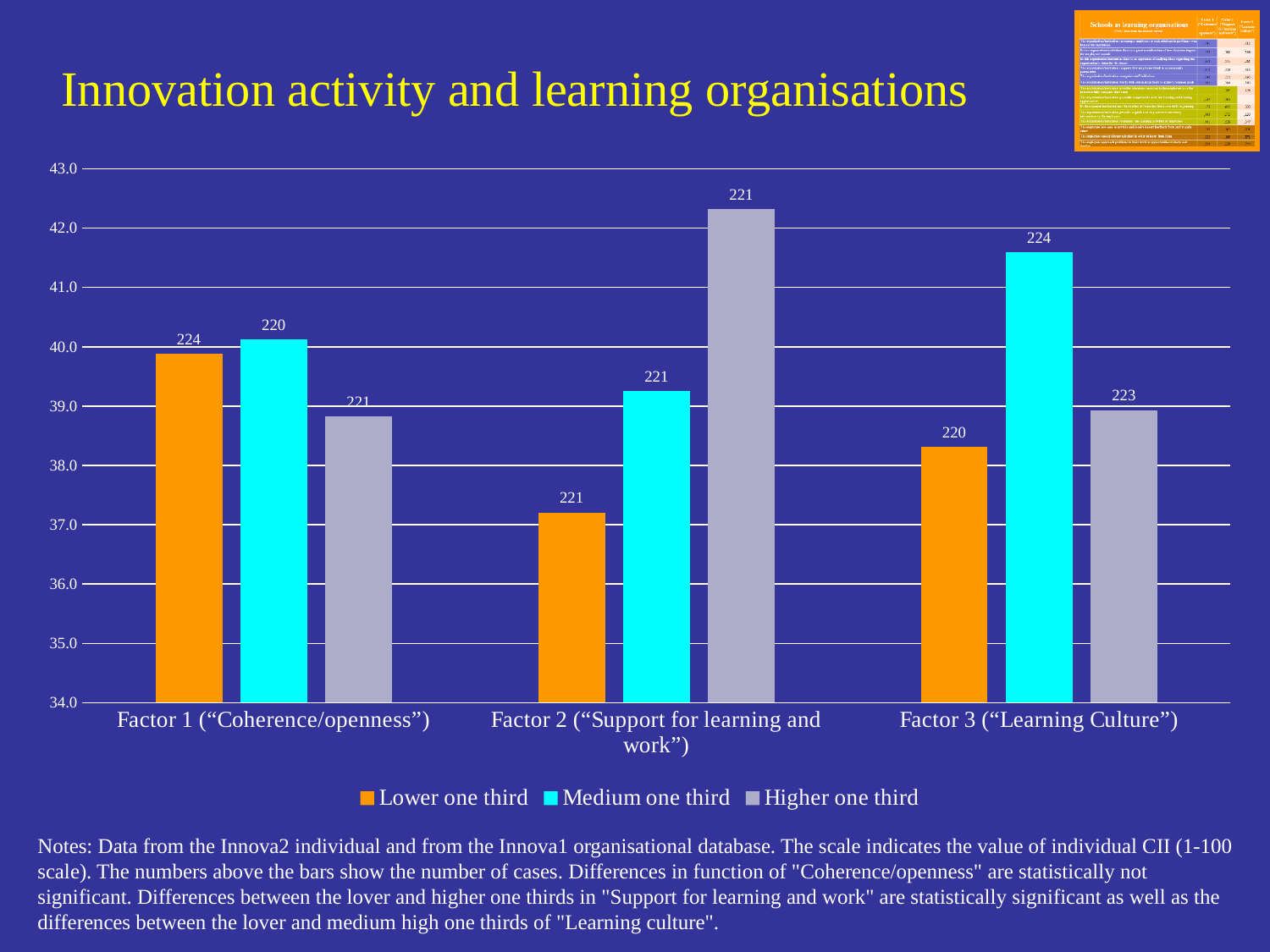
Which is larger: the Higher one third bar for Factor 2 or the Medium one third bar for Factor 3? Higher one third bar for Factor 2 Is the value for Lower one third in Factor 2 ("Support for learning and work") greater or less than 38? less What number of cases is printed above the Lower one third bar for Factor 1 ("Coherence/openness")? 224 What is the title of the chart? Innovation activity and learning organisations How many factor categories are shown on the x axis? 3 Which series has the tallest bar for Factor 3 ("Learning Culture")? Medium one third How many series does the legend list? 3 Which series has the tallest bar for Factor 2 ("Support for learning and work")? Higher one third What kind of chart is shown on the slide? Bar chart Is the value for Medium one third in Factor 3 ("Learning Culture") greater or less than 41? greater Which series has the shortest bar for Factor 2 ("Support for learning and work")? Lower one third Is the value for Higher one third in Factor 2 ("Support for learning and work") greater or less than 42? greater